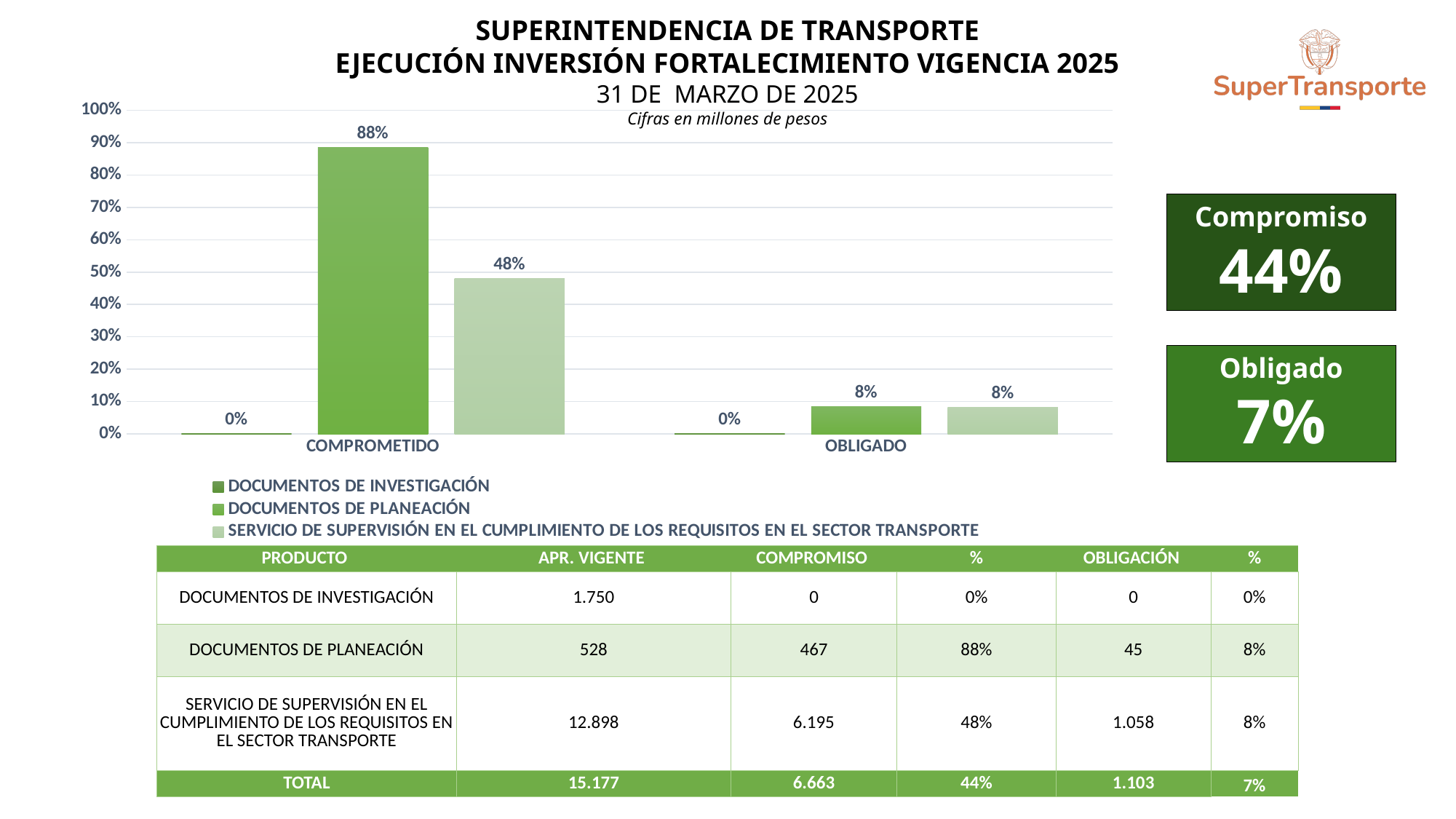
What is the highest value shown on the chart's y axis? 100% Which is larger for DOCUMENTOS DE PLANEACIÓN: the COMPROMETIDO value or the OBLIGADO value? COMPROMETIDO What is the difference between the COMPROMETIDO values for DOCUMENTOS DE PLANEACIÓN and SERVICIO DE SUPERVISIÓN EN EL CUMPLIMIENTO DE LOS REQUISITOS EN EL SECTOR TRANSPORTE? 40% How many series does the chart legend list? 3 What is the value for SERVICIO DE SUPERVISIÓN EN EL CUMPLIMIENTO DE LOS REQUISITOS EN EL SECTOR TRANSPORTE in the COMPROMETIDO category? 48% Which series has the highest value in the COMPROMETIDO category? DOCUMENTOS DE PLANEACIÓN Which series has the lowest value in the OBLIGADO category? DOCUMENTOS DE INVESTIGACIÓN What is the value for DOCUMENTOS DE PLANEACIÓN in the COMPROMETIDO category? 88% What is the value for DOCUMENTOS DE INVESTIGACIÓN in the OBLIGADO category? 0% What is the value for DOCUMENTOS DE PLANEACIÓN in the OBLIGADO category? 8% What kind of chart is shown on the slide? bar chart How many categories are shown on the x axis of the chart? 2